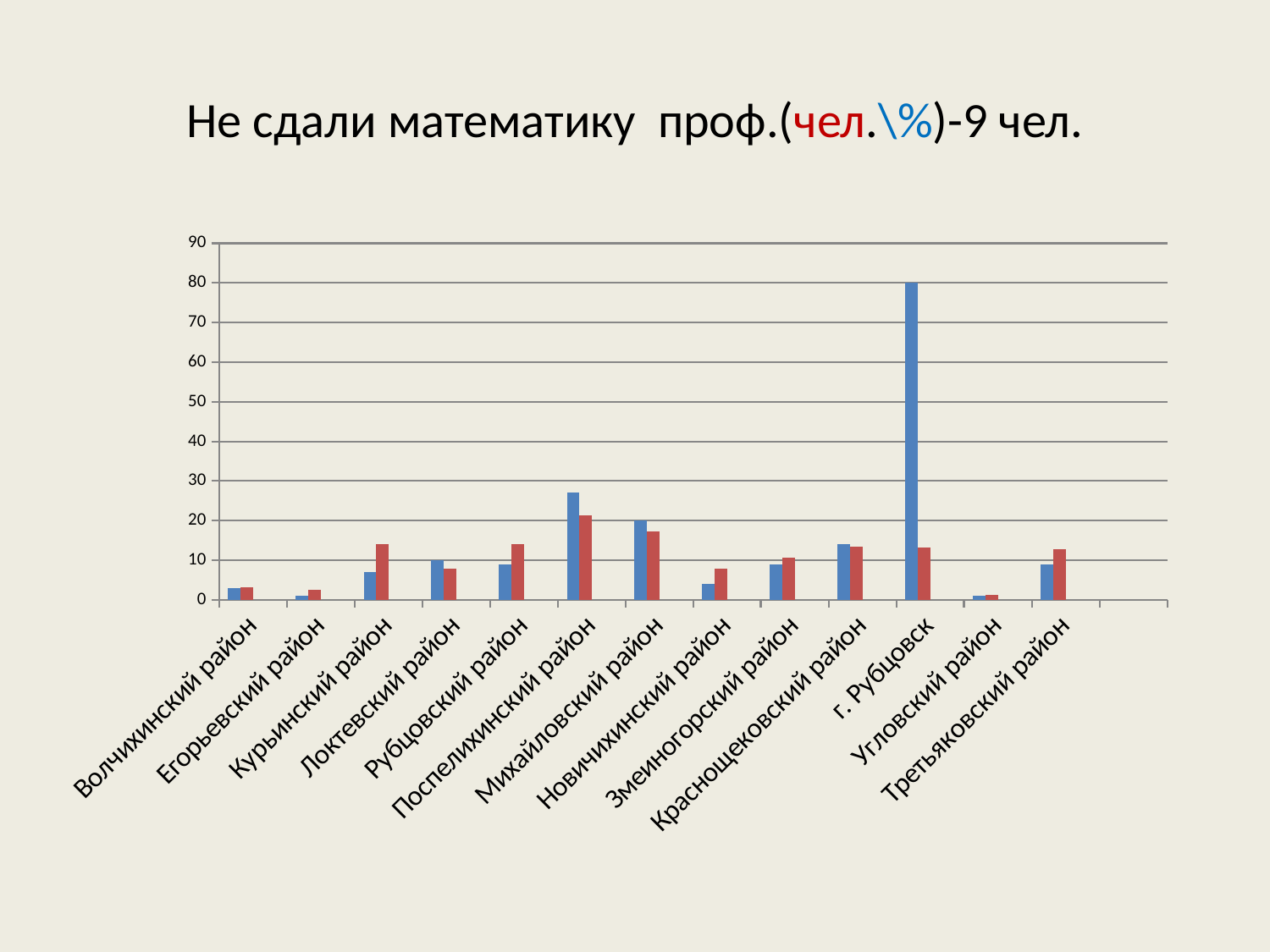
What kind of chart is shown on the slide? bar chart Which has the taller blue bar, Поспелихинский район or Михайловский район? Поспелихинский район How many districts are labelled on the x axis of the chart? 13 Is the blue bar for г. Рубцовск greater or less than 70? greater What two colours are used for the bars in the chart? blue and red Is the red bar for Курьинский район greater or less than 10? greater What is the title of the slide above the chart? Не сдали математику проф.(чел.\%)-9 чел. Which district has the tallest blue bar? г. Рубцовск Is the blue bar for Поспелихинский район greater or less than 20? greater For Курьинский район, which bar is taller, the blue one or the red one? the red one